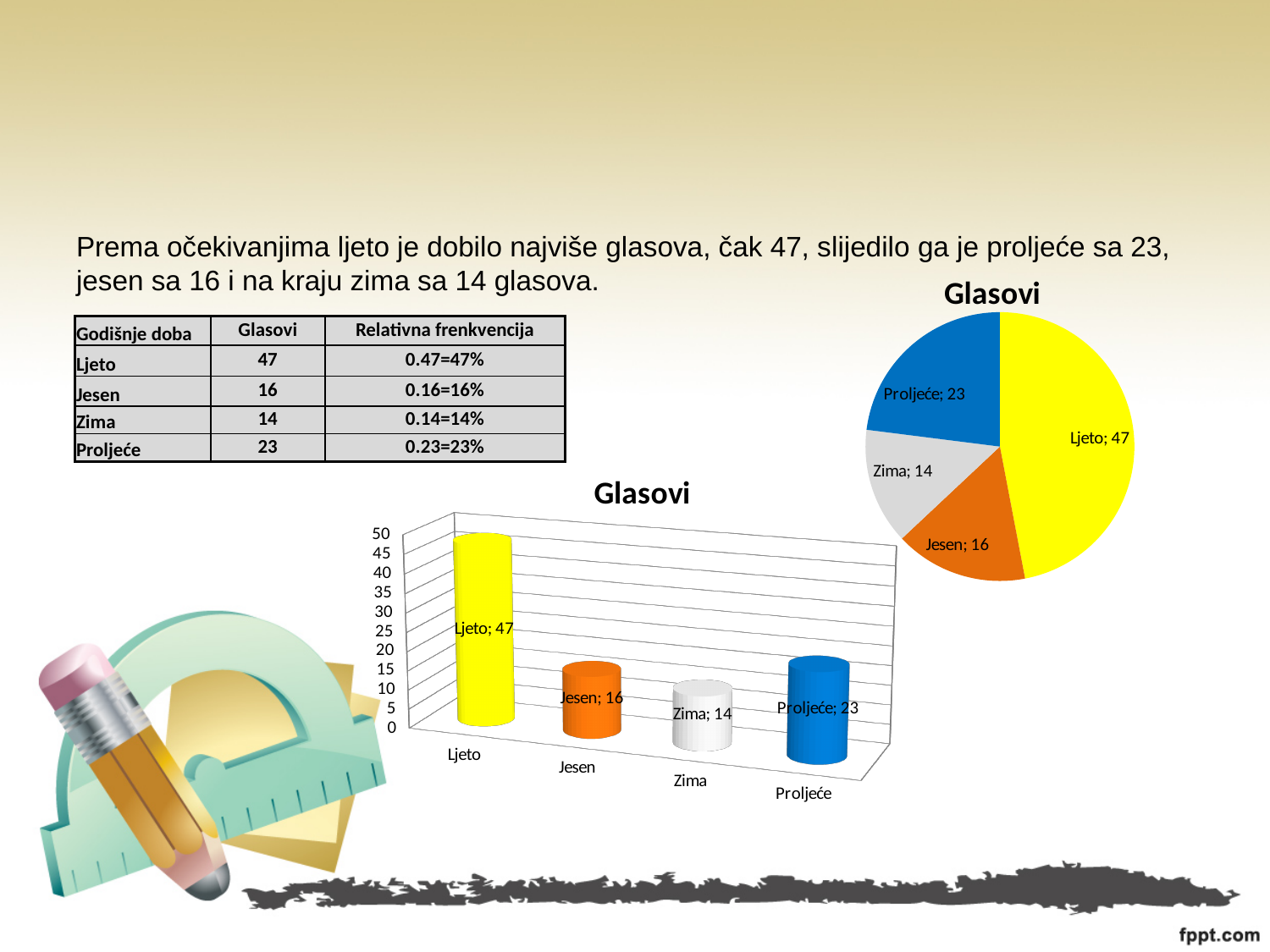
In the pie chart at the top right, which is larger, Jesen or Proljeće? Proljeće In the bar chart at the bottom of the slide, which category has the highest value? Ljeto In the bar chart at the bottom of the slide, what is the value for Ljeto? 47 In the bar chart at the bottom of the slide, what is the value for Zima? 14 What is the title of the bar chart at the bottom of the slide? Glasovi What kind of chart is the chart at the top right of the slide? pie chart In the bar chart at the bottom of the slide, is the value for Jesen greater or less than 20? less How many categories are shown in the bar chart at the bottom of the slide? 4 In the pie chart at the top right, what is the value shown for Proljeće? 23 In the pie chart at the top right, what share of the total does Ljeto represent? 47% In the bar chart at the bottom of the slide, what is the difference between the values for Ljeto and Proljeće? 24 In the pie chart at the top right, which category has the smallest slice? Zima